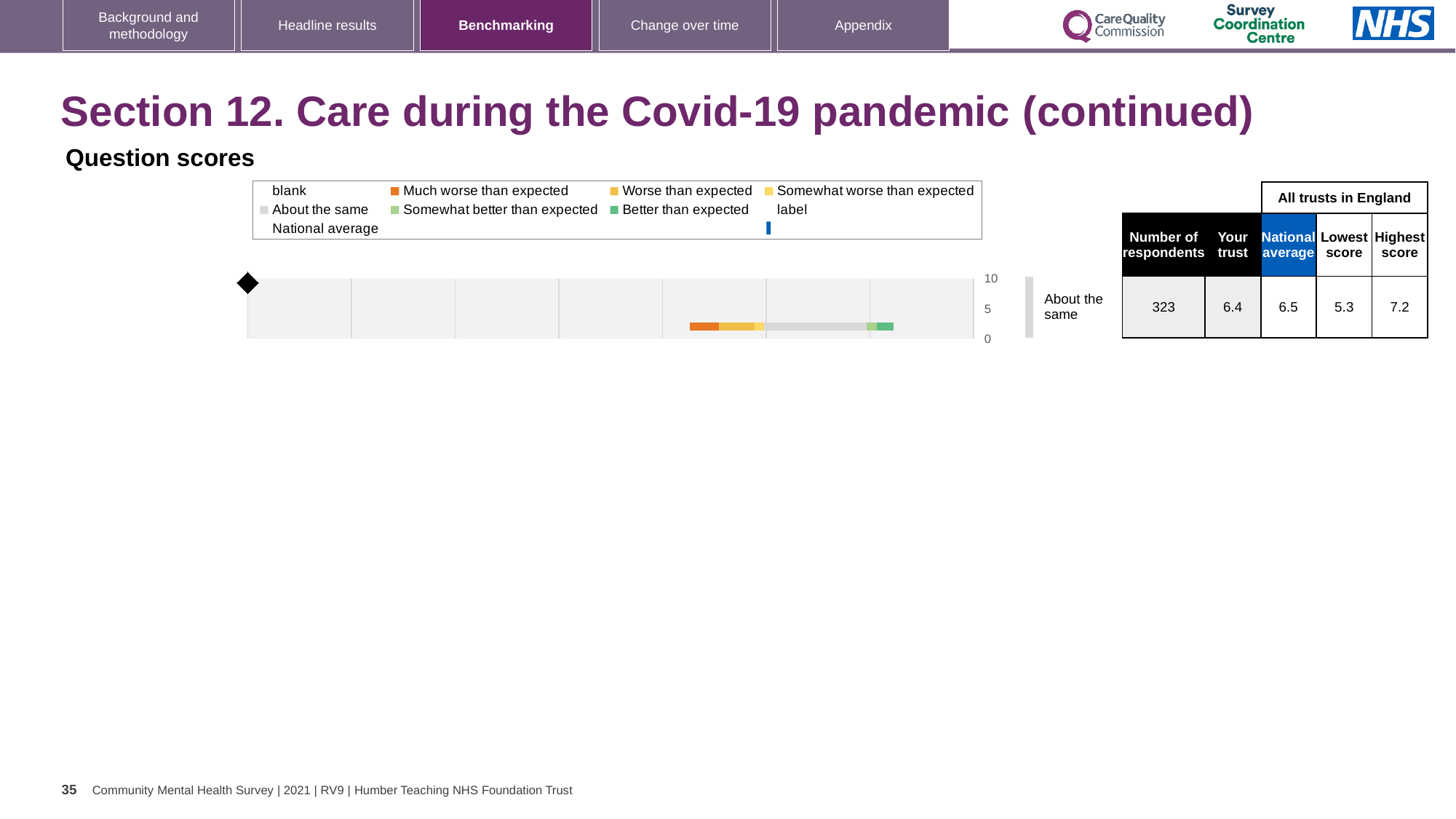
What is the national average score shown in the table next to the chart? 6.5 What is the difference between the highest score and the lowest score in the table? 1.9 Which is larger, the 'Your trust' score or the national average? National average What is the highest score among all trusts in England shown in the table? 7.2 What is the maximum value shown on the chart's axis? 10 Is the 'Your trust' score greater or less than 5? greater What benchmark category is the trust's score assigned to, as labelled beside the chart? About the same What kind of chart is shown on the slide? Bar chart What colour does the legend use for 'Much worse than expected'? Orange What is the 'Your trust' score shown in the table next to the chart? 6.4 How many respondents are listed in the table next to the chart? 323 What is the lowest score among all trusts in England shown in the table? 5.3